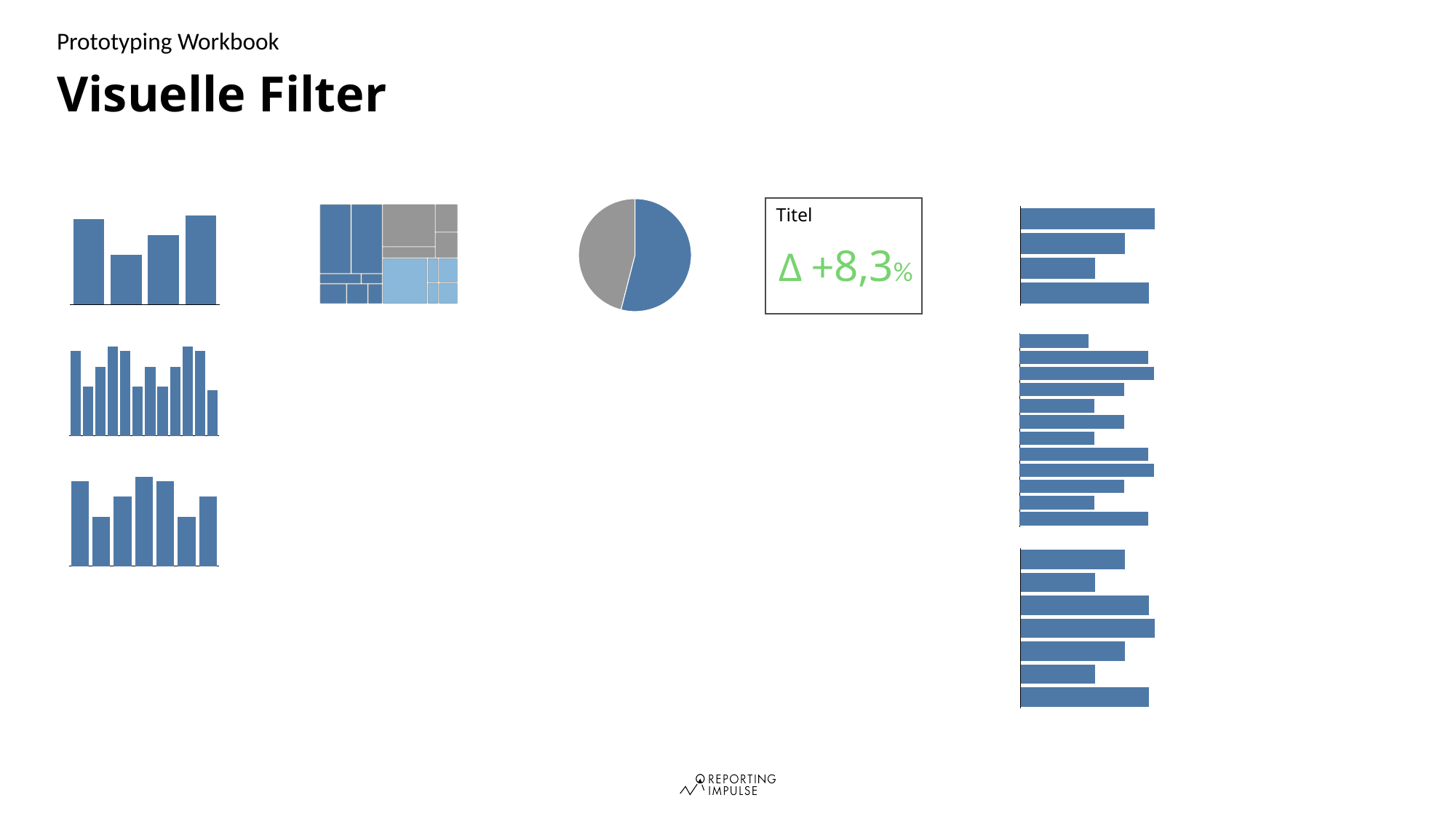
In the top-left bar chart, which bar is the shortest? the second bar What kind of chart is the top-left chart on the slide? bar chart How many bars does the top-left bar chart have? 4 What kind of chart is the rectangle-based chart second from the left in the top row? treemap In the pie chart, which slice is larger, the blue one or the grey one? the blue one What value is shown in the KPI tile labelled "Titel"? Δ +8,3% How many bars does the middle chart on the left side of the slide have? 12 What kind of chart is the circular chart in the middle of the slide? pie chart How many slices does the pie chart have? 2 In the top-left bar chart, which bar is the tallest? the fourth (rightmost) bar